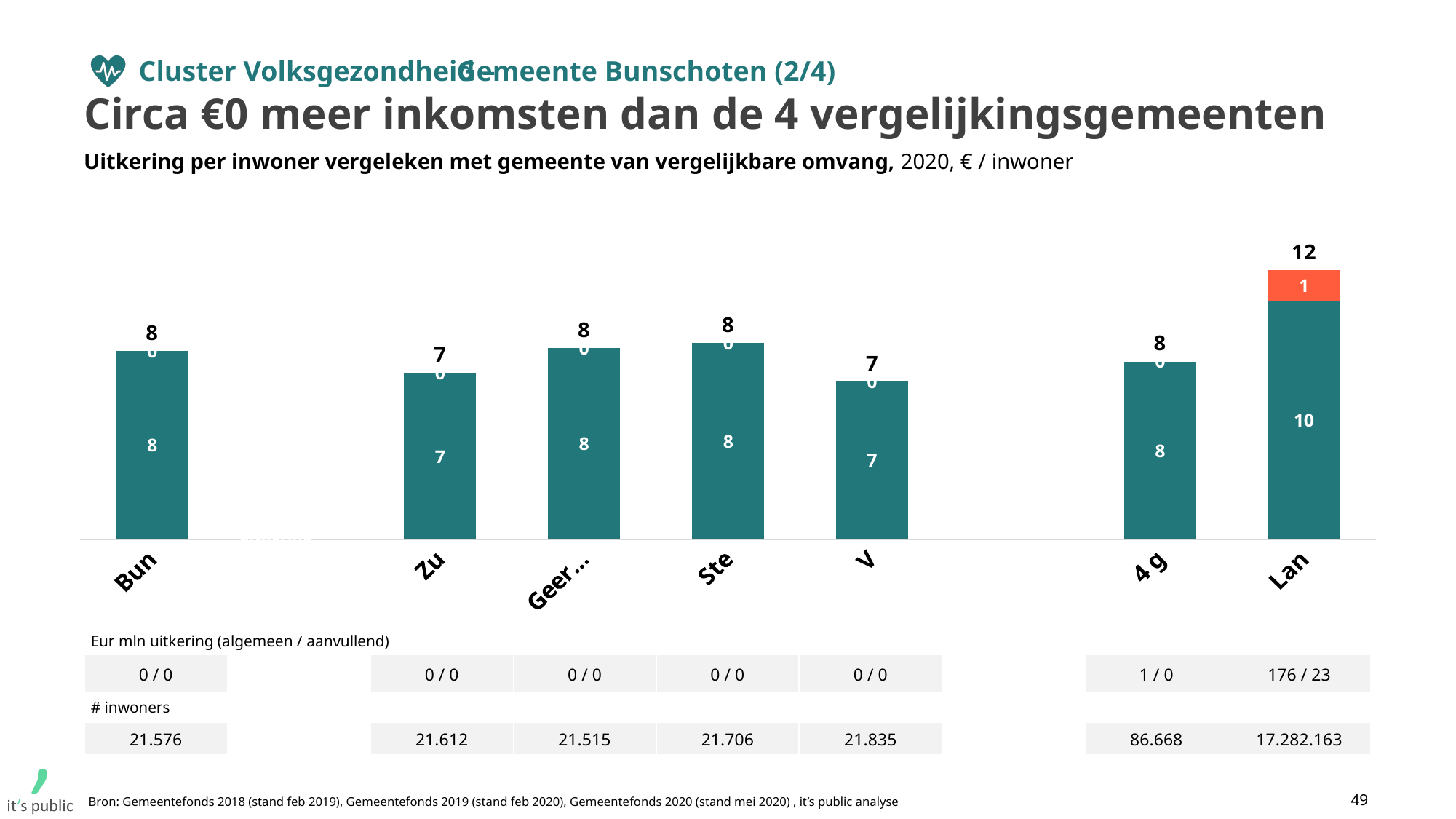
What kind of chart is shown on the slide? Stacked bar chart What is the total value shown above the bar for Zu? 7 How many bars are plotted in the chart? 7 Which category has the highest total value? Lan What is the value of the teal (lower) segment of the Lan bar? 10 Which is larger, the total for Ste or the total for V? Ste What is the total value shown above the bar for Lan? 12 What is the number of inhabitants (# inwoners) listed under Bun? 21.576 What is the value of the orange (upper) segment of the Lan bar? 1 What is the total value shown above the bar for Bun? 8 What is the difference between the total for Lan and the total for Bun? 4